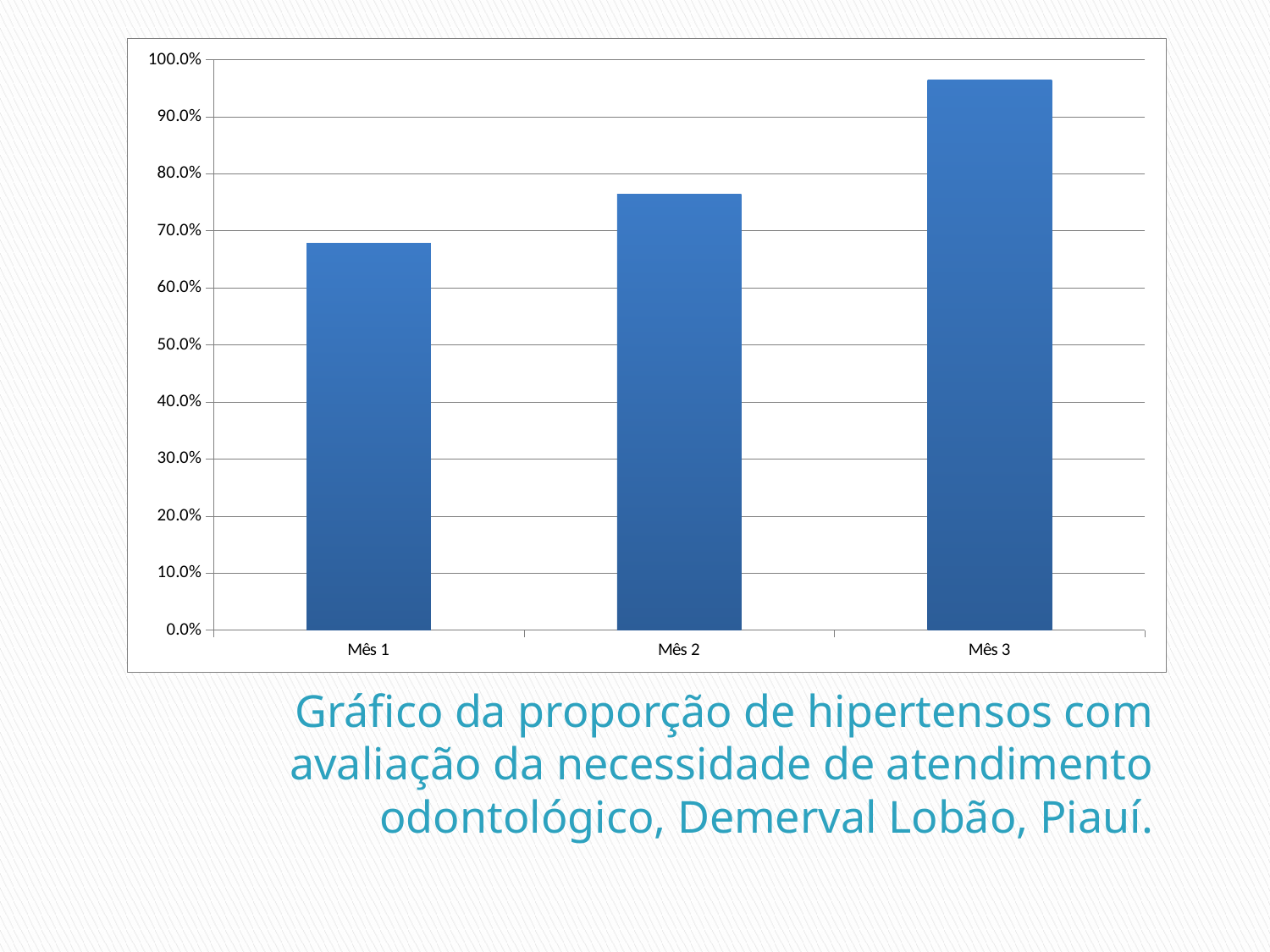
What is the highest value shown on the vertical axis of the chart? 100.0% What kind of chart is shown on the slide? Bar chart Which is larger, the value for Mês 2 or the value for Mês 3? Mês 3 Do the values rise or fall from Mês 1 to Mês 3? Rise Is the value for Mês 1 greater or less than 60.0%? greater Which month has the lowest proportion on the chart? Mês 1 Which month has the highest proportion on the chart? Mês 3 Is the value for Mês 3 greater or less than 90.0%? greater Which is larger, the value for Mês 1 or the value for Mês 2? Mês 2 Is the value for Mês 2 greater or less than 80.0%? less How many categories (months) are plotted on the chart? 3